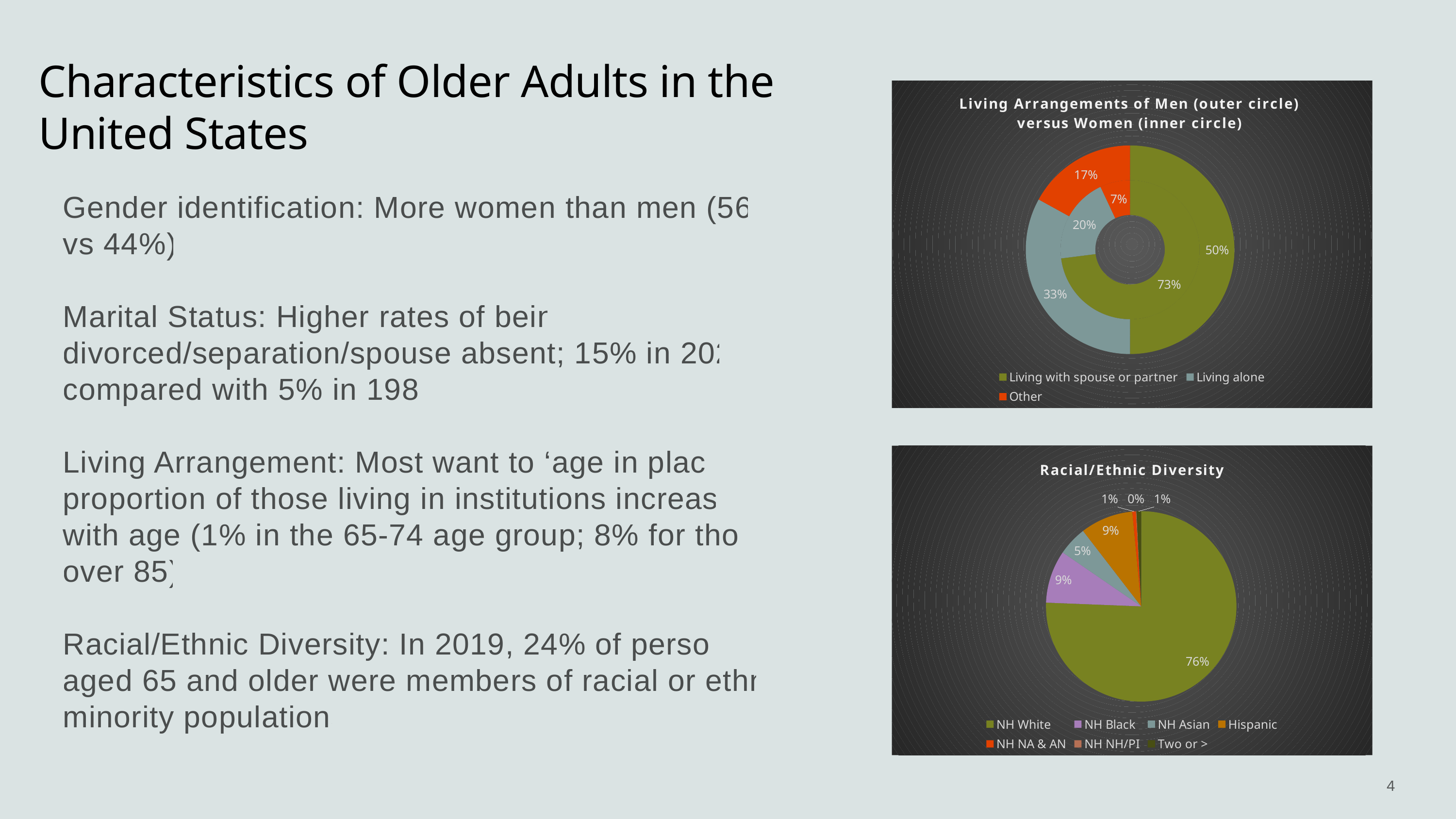
In the 'Living Arrangements of Men (outer circle) versus Women (inner circle)' chart, how many categories does the legend list? 3 In the 'Living Arrangements of Men (outer circle) versus Women (inner circle)' chart, what percentage of women (inner circle) are living with a spouse or partner? 73% In the 'Racial/Ethnic Diversity' chart, how many categories does the legend list? 7 In the 'Living Arrangements of Men (outer circle) versus Women (inner circle)' chart, what percentage of men (outer circle) are living alone? 33% What kind of chart is the 'Racial/Ethnic Diversity' chart? Pie chart In the 'Racial/Ethnic Diversity' chart, what is the share for NH White? 76% In the 'Racial/Ethnic Diversity' chart, what is the share for NH Asian? 5% In the 'Racial/Ethnic Diversity' chart, which category has the smallest share? NH NH/PI In the 'Racial/Ethnic Diversity' chart, which category has the largest share? NH White What kind of chart is the 'Living Arrangements of Men (outer circle) versus Women (inner circle)' chart? Doughnut chart In the 'Living Arrangements of Men (outer circle) versus Women (inner circle)' chart, what percentage of men (outer circle) are living with a spouse or partner? 50% In the 'Living Arrangements of Men (outer circle) versus Women (inner circle)' chart, what is the difference between the 'Other' share for men (outer circle) and for women (inner circle)? 10%